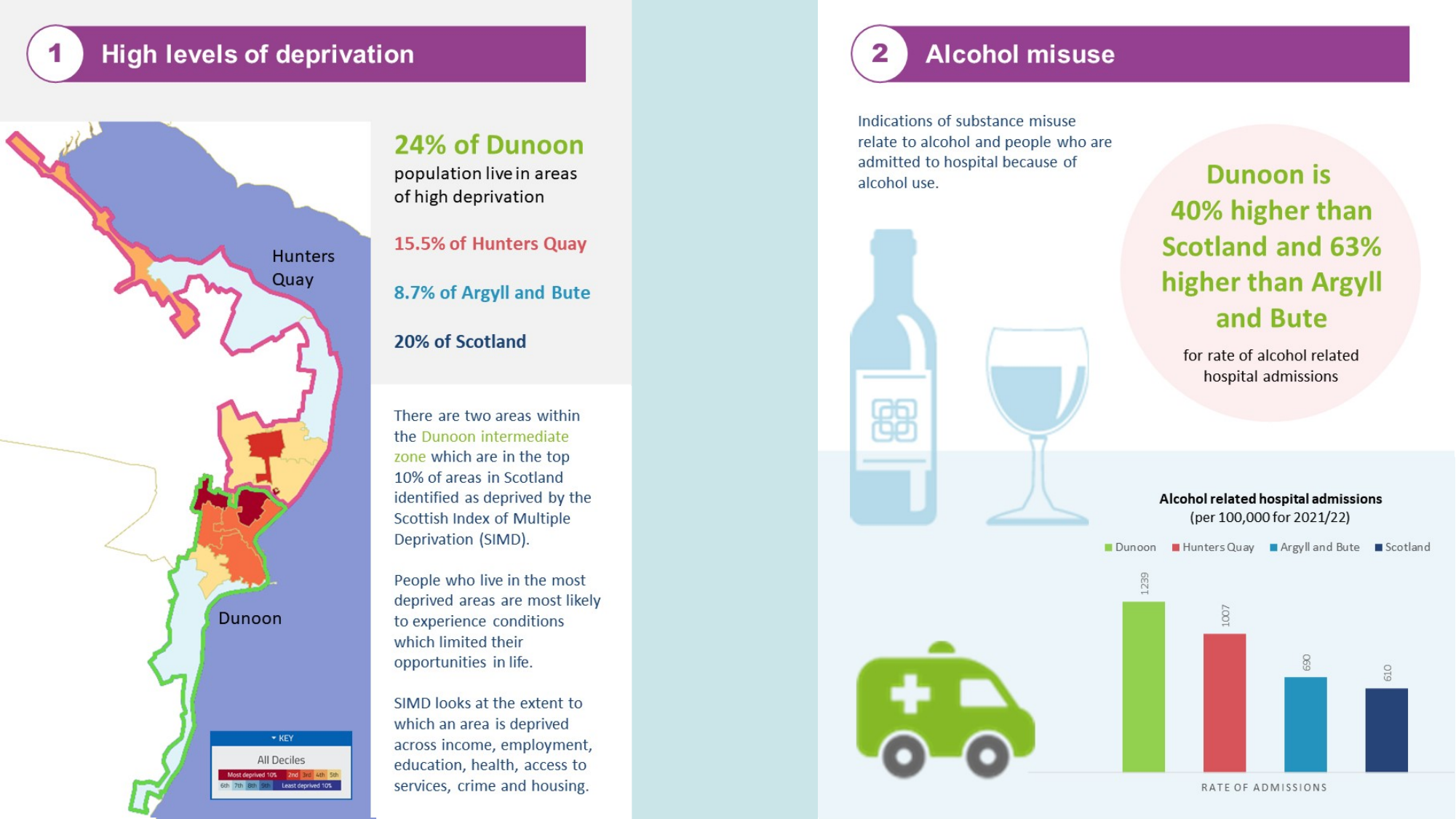
What is the difference between the Dunoon and Scotland values in the Alcohol related hospital admissions chart? 629 Which area has the lowest rate of admissions in the Alcohol related hospital admissions chart? Scotland What is the difference between the Hunters Quay and Argyll and Bute values in the Alcohol related hospital admissions chart? 317 What is the value for Argyll and Bute in the Alcohol related hospital admissions chart? 690 What is the value for Dunoon in the Alcohol related hospital admissions chart? 1239 How many bars are shown in the Alcohol related hospital admissions chart? 4 What is the value for Hunters Quay in the Alcohol related hospital admissions chart? 1007 How many entries does the legend of the Alcohol related hospital admissions chart list? 4 Which area has the highest rate of admissions in the Alcohol related hospital admissions chart? Dunoon In the Alcohol related hospital admissions chart, which is larger, the value for Hunters Quay or the value for Argyll and Bute? Hunters Quay What type of chart is the Alcohol related hospital admissions chart? Bar chart What is the value for Scotland in the Alcohol related hospital admissions chart? 610